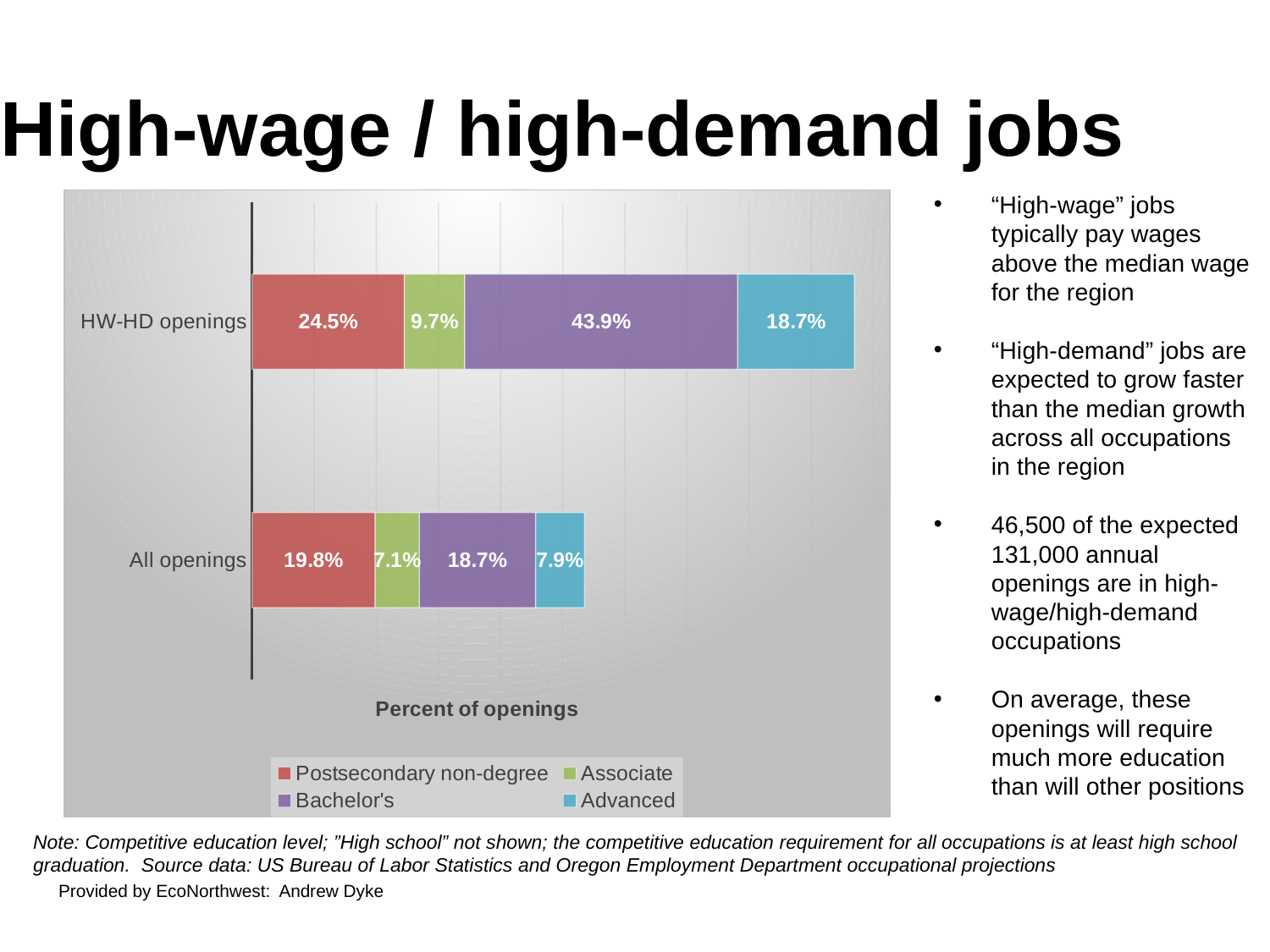
What is the Associate value for HW-HD openings? 9.7% How many series does the legend list? 4 What is the difference between the Bachelor's value for HW-HD openings and for All openings? 25.2 percentage points Which education level has the smallest share of All openings? Associate What type of chart is shown on the slide? Stacked bar chart What is the Bachelor's value for HW-HD openings? 43.9% Which is larger: the Advanced value for HW-HD openings or for All openings? HW-HD openings What is the Advanced value for All openings? 7.9% Which education level has the largest share of HW-HD openings? Bachelor's What is the Postsecondary non-degree value for All openings? 19.8% What is the x-axis title of the chart? Percent of openings What is the total of the stacked bar for All openings? 53.5%